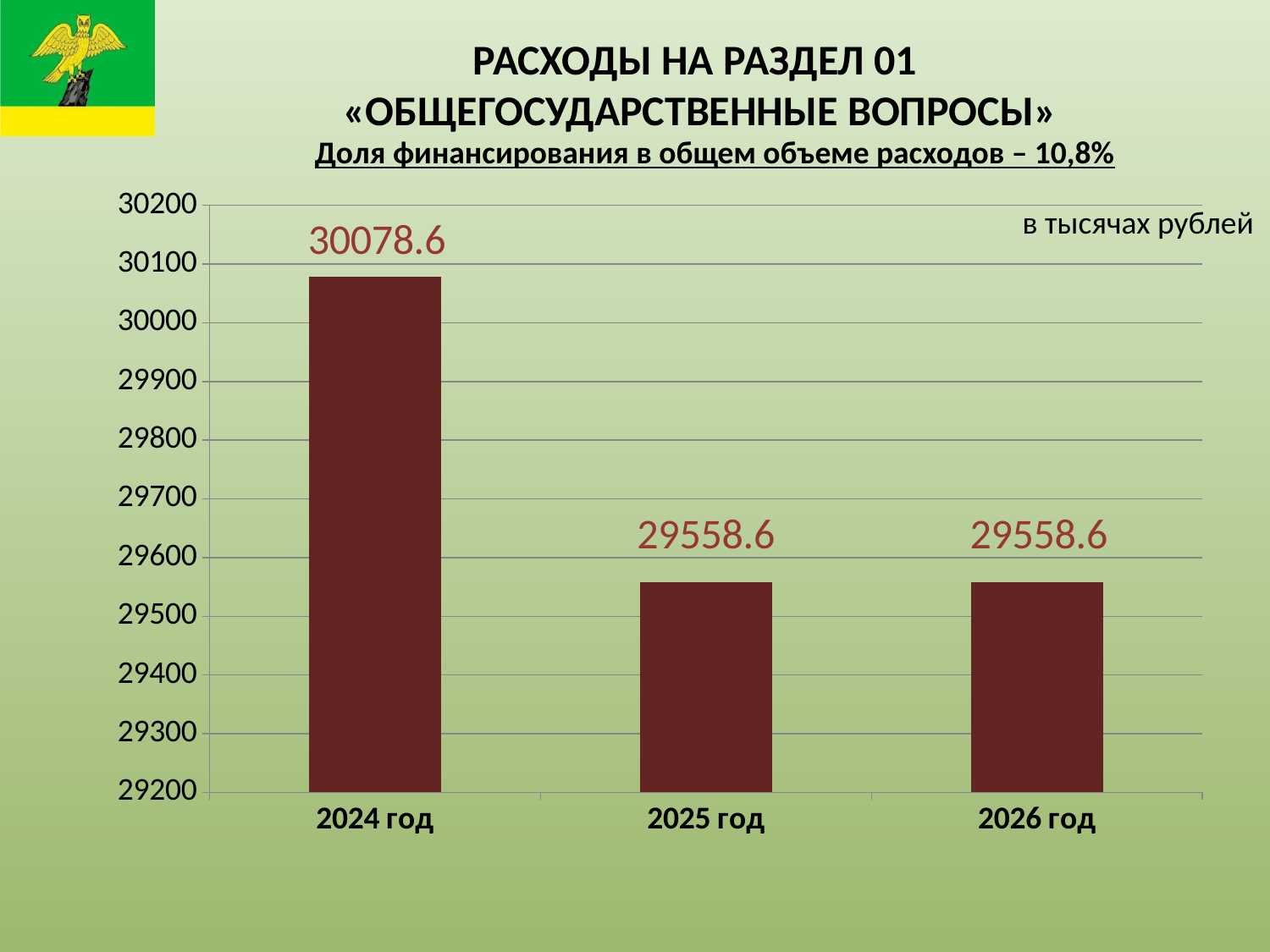
Is the value for 2025 год greater or less than 29600? less Which is larger, the value for 2024 год or the value for 2026 год? 2024 год What is the value for 2025 год? 29558.6 What kind of chart is shown on the slide? bar chart What is the difference between the values for 2024 год and 2025 год? 520 What is the value for 2024 год? 30078.6 Is the value for 2024 год greater or less than 30000? greater Do the values rise or fall from 2024 год to 2025 год? fall In what units are the values on the chart given? в тысячах рублей What is the value for 2026 год? 29558.6 Which year has the highest value? 2024 год How many years are shown on the chart? 3